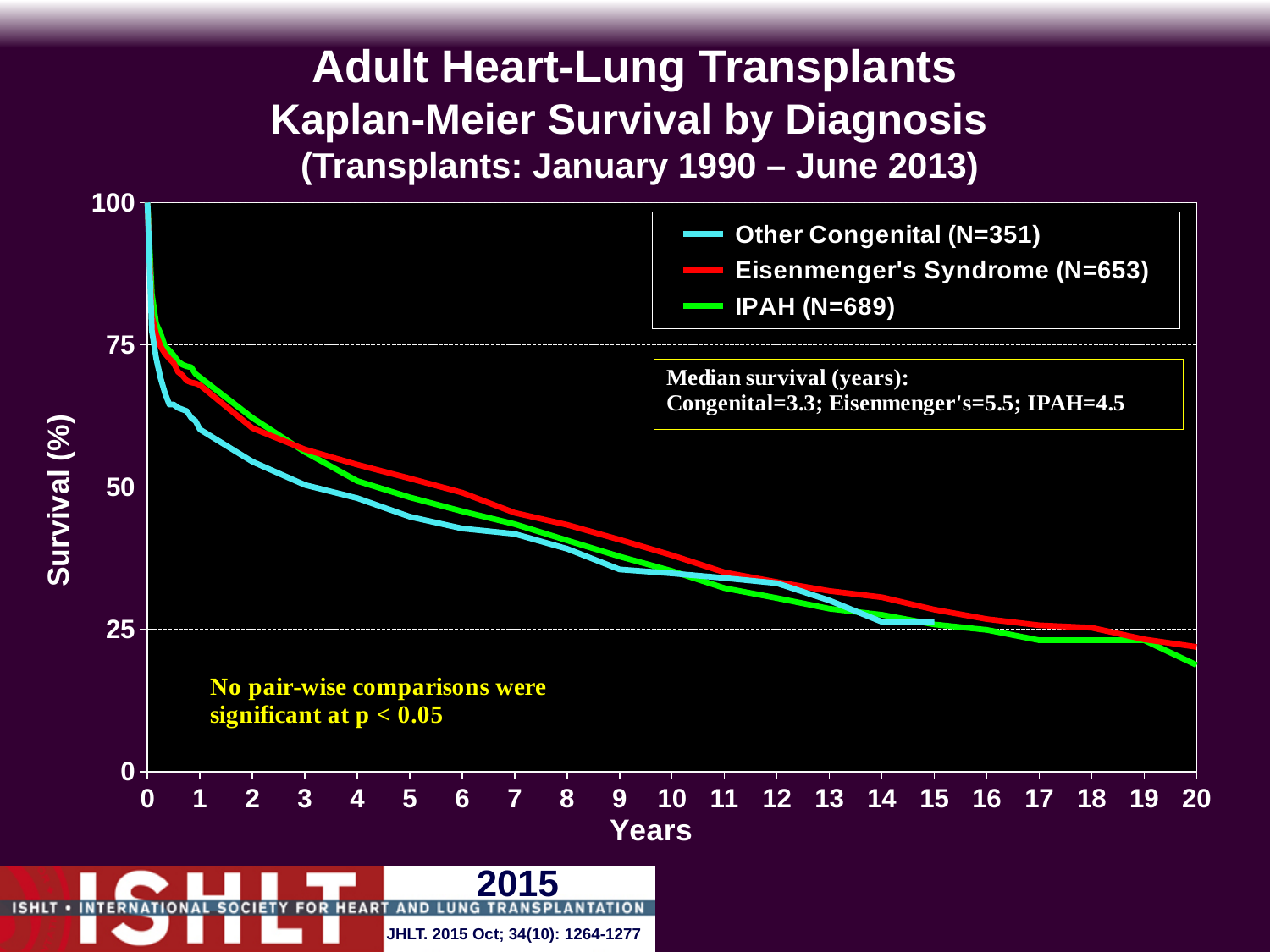
What is the median survival in years for the IPAH group? 4.5 How many series does the legend list? 3 What is the median survival in years for the Eisenmenger's Syndrome group? 5.5 At 1 year, which has higher survival: Eisenmenger's Syndrome or Other Congenital? Eisenmenger's Syndrome What is the difference in median survival (years) between Eisenmenger's and Congenital? 2.2 What kind of chart is shown on the slide? line chart How many patients (N) are in the IPAH group according to the legend? 689 Which diagnosis group has the lowest median survival? Other Congenital Do the survival curves rise or fall as years increase? fall Is the survival value for Other Congenital at 10 years greater or less than 50? less Which diagnosis group has the highest median survival? Eisenmenger's Syndrome Is the survival value for IPAH at 20 years greater or less than 25? less